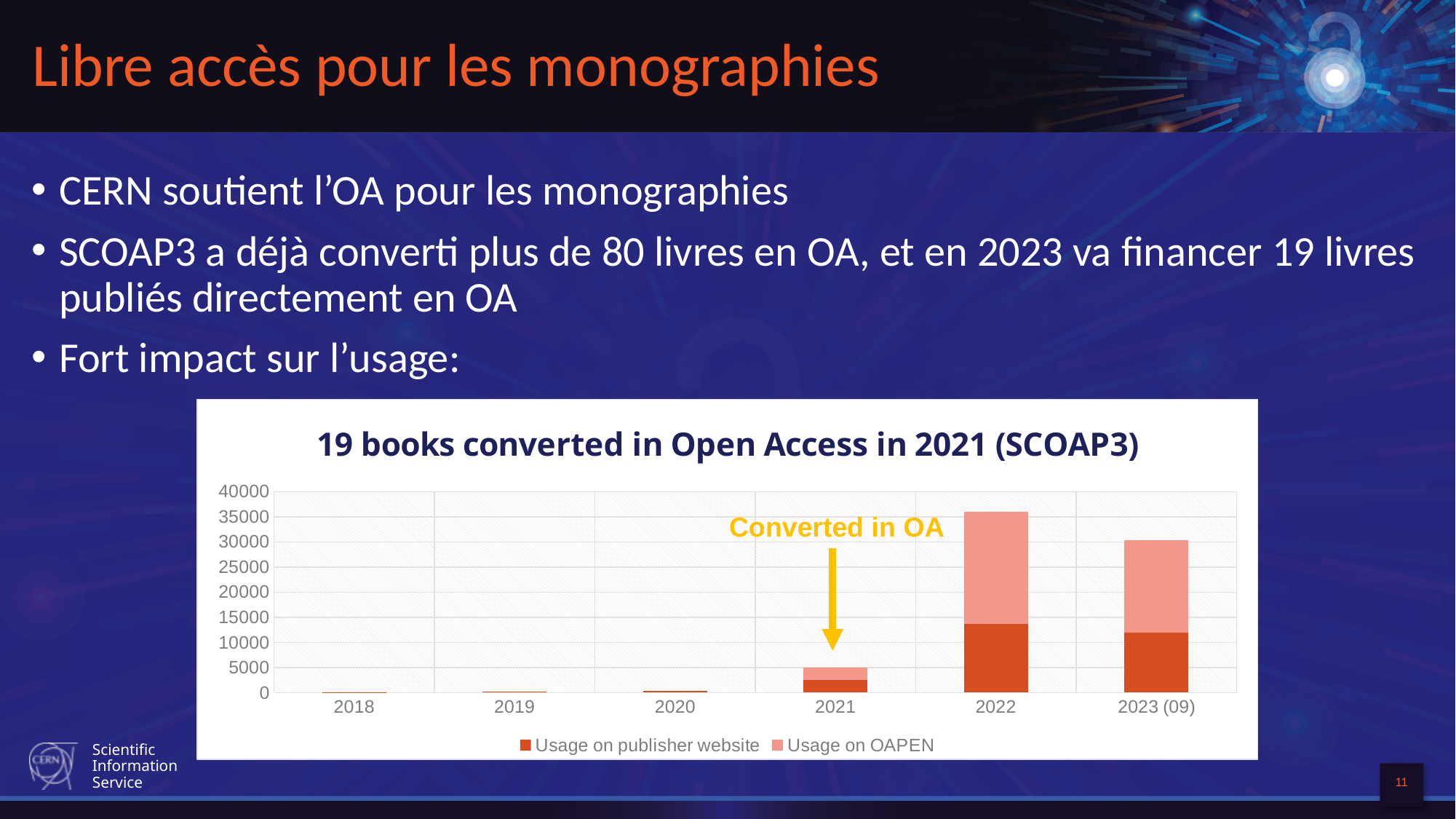
Is the total usage for 2023 (09) greater or less than 25000? greater How many series does the chart legend list? 2 Which year has the lowest total usage in the chart? 2018 Which year does the 'Converted in OA' arrow annotation point to? 2021 Is the total usage for 2022 greater or less than 30000? greater How many year categories are shown on the x axis of the chart? 6 Which year has the highest total usage in the chart? 2022 What is the title of the chart? 19 books converted in Open Access in 2021 (SCOAP3) Which year has the larger total usage, 2022 or 2023 (09)? 2022 Is the total usage for 2021 greater or less than 10000? less What kind of chart is shown on the slide? stacked bar chart